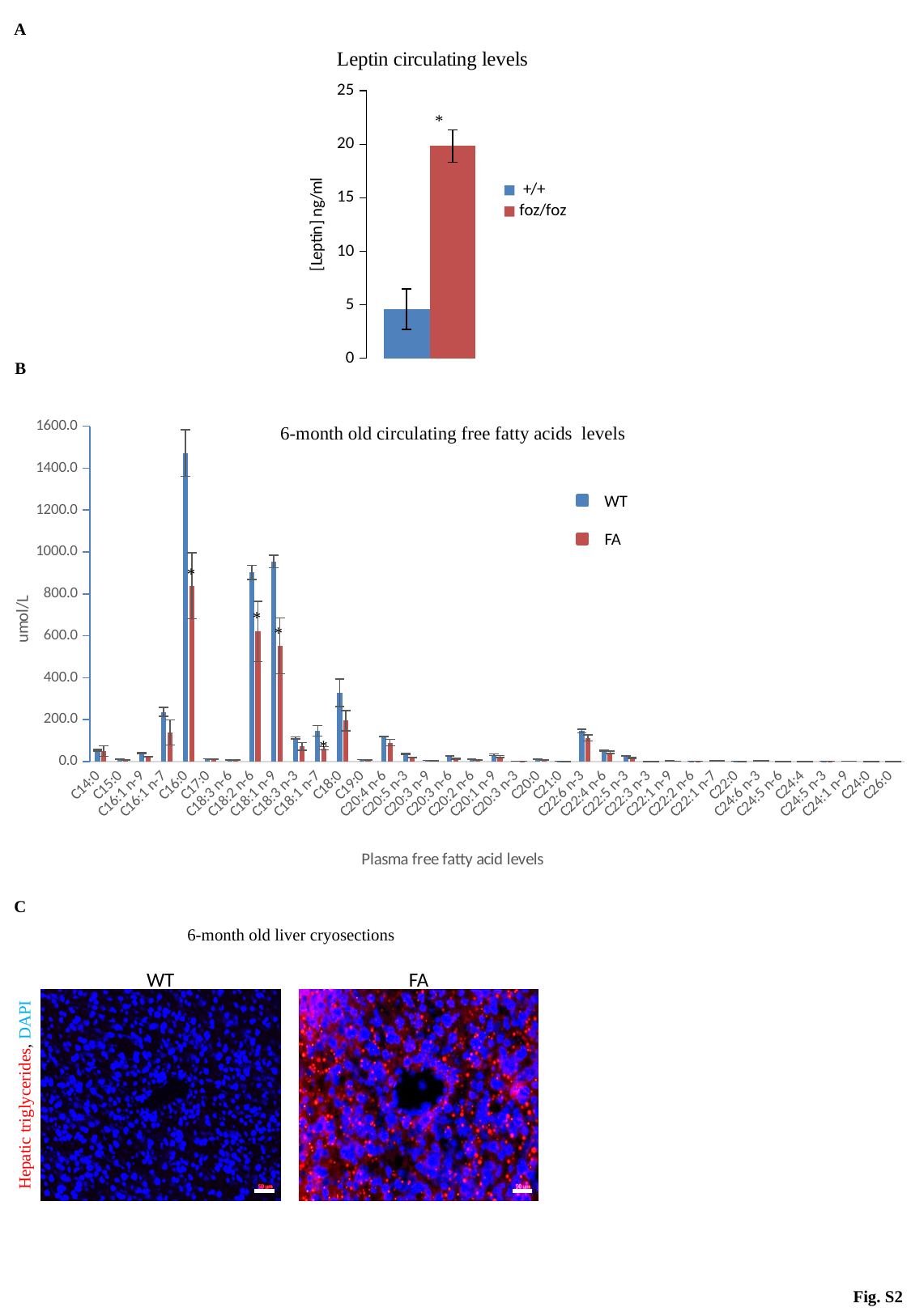
In the 'Leptin circulating levels' chart, what kind of chart is shown? bar chart In the '6-month old circulating free fatty acids levels' chart, for C16:0, which series has the larger value, WT or FA? WT In the 'Leptin circulating levels' chart, which group has the higher leptin level, +/+ or foz/foz? foz/foz In the '6-month old circulating free fatty acids levels' chart, is the WT value for C18:0 greater or less than 200? greater In the 'Leptin circulating levels' chart, how many series does the legend list? 2 In the 'Leptin circulating levels' chart, is the value for +/+ greater or less than 10? less In the '6-month old circulating free fatty acids levels' chart, is the WT value for C16:0 greater or less than 1200? greater In the '6-month old circulating free fatty acids levels' chart, what are the two series listed in the legend? WT and FA In the 'Leptin circulating levels' chart, what is the label on the vertical axis? [Leptin] ng/ml In the '6-month old circulating free fatty acids levels' chart, which fatty acid has the highest WT value? C16:0